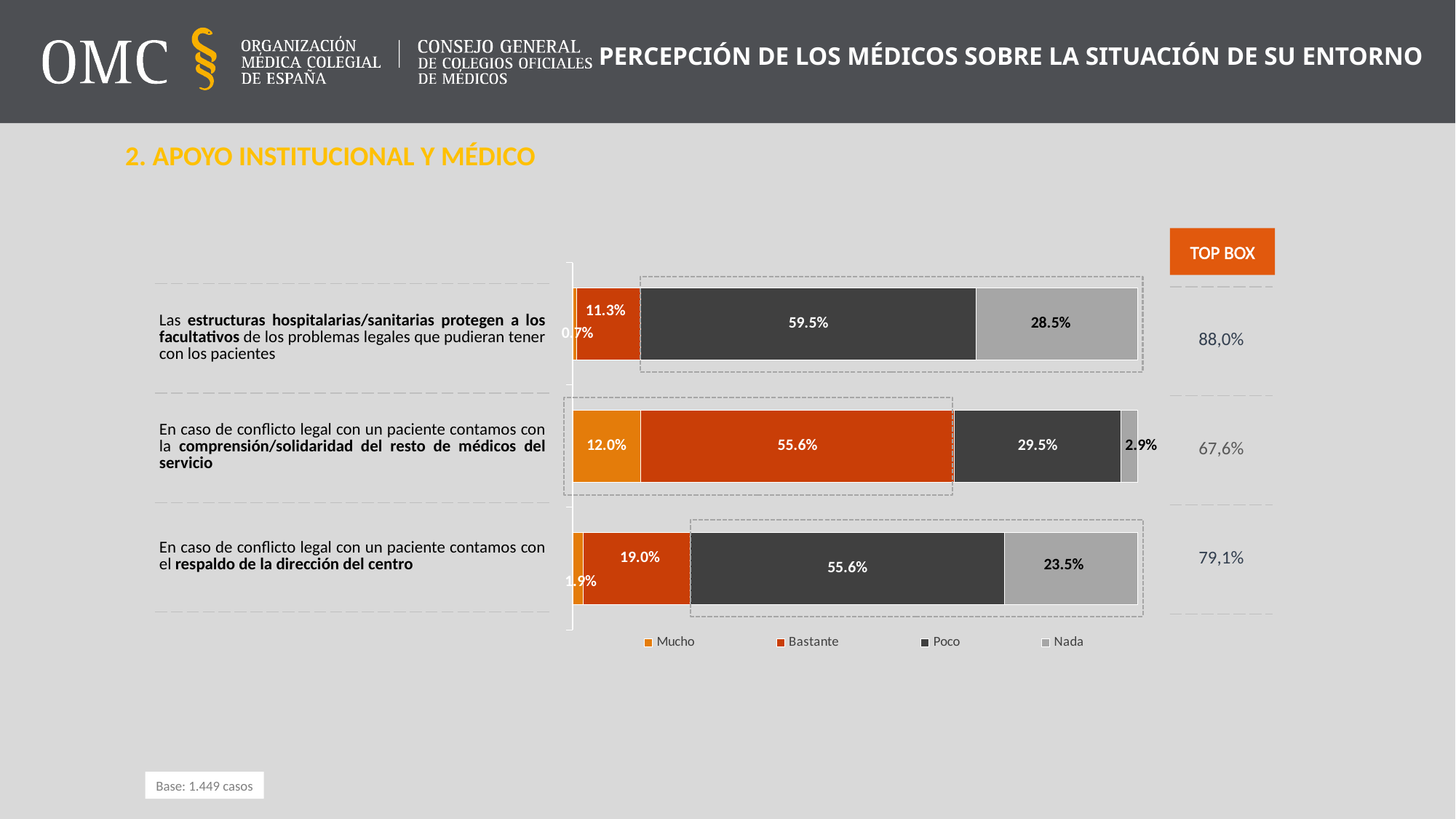
Which statement has the lowest 'Mucho' value? Las estructuras hospitalarias/sanitarias protegen a los facultativos de los problemas legales que pudieran tener con los pacientes What kind of chart is shown on the slide? Stacked bar chart What is the 'Nada' value for the statement about 'respaldo de la dirección del centro'? 23.5% How many series does the chart legend list? 4 What is the 'Bastante' value for the statement about 'comprensión/solidaridad del resto de médicos del servicio'? 55.6% What is the difference between the 'Bastante' values for the 'respaldo de la dirección del centro' statement and the 'estructuras hospitalarias/sanitarias' statement? 7.7% Which is larger: the 'Poco' value for the 'comprensión/solidaridad' statement or the 'Poco' value for the 'respaldo de la dirección del centro' statement? Respaldo de la dirección del centro (55.6%) Which legend entry is shown in the lightest grey colour? Nada How many statements (categories) are plotted in the chart? 3 Which statement has the highest 'Nada' value? Las estructuras hospitalarias/sanitarias protegen a los facultativos de los problemas legales que pudieran tener con los pacientes What is the 'Mucho' value for the statement about 'comprensión/solidaridad del resto de médicos del servicio'? 12.0% What is the 'Poco' value for the statement 'Las estructuras hospitalarias/sanitarias protegen a los facultativos de los problemas legales que pudieran tener con los pacientes'? 59.5%